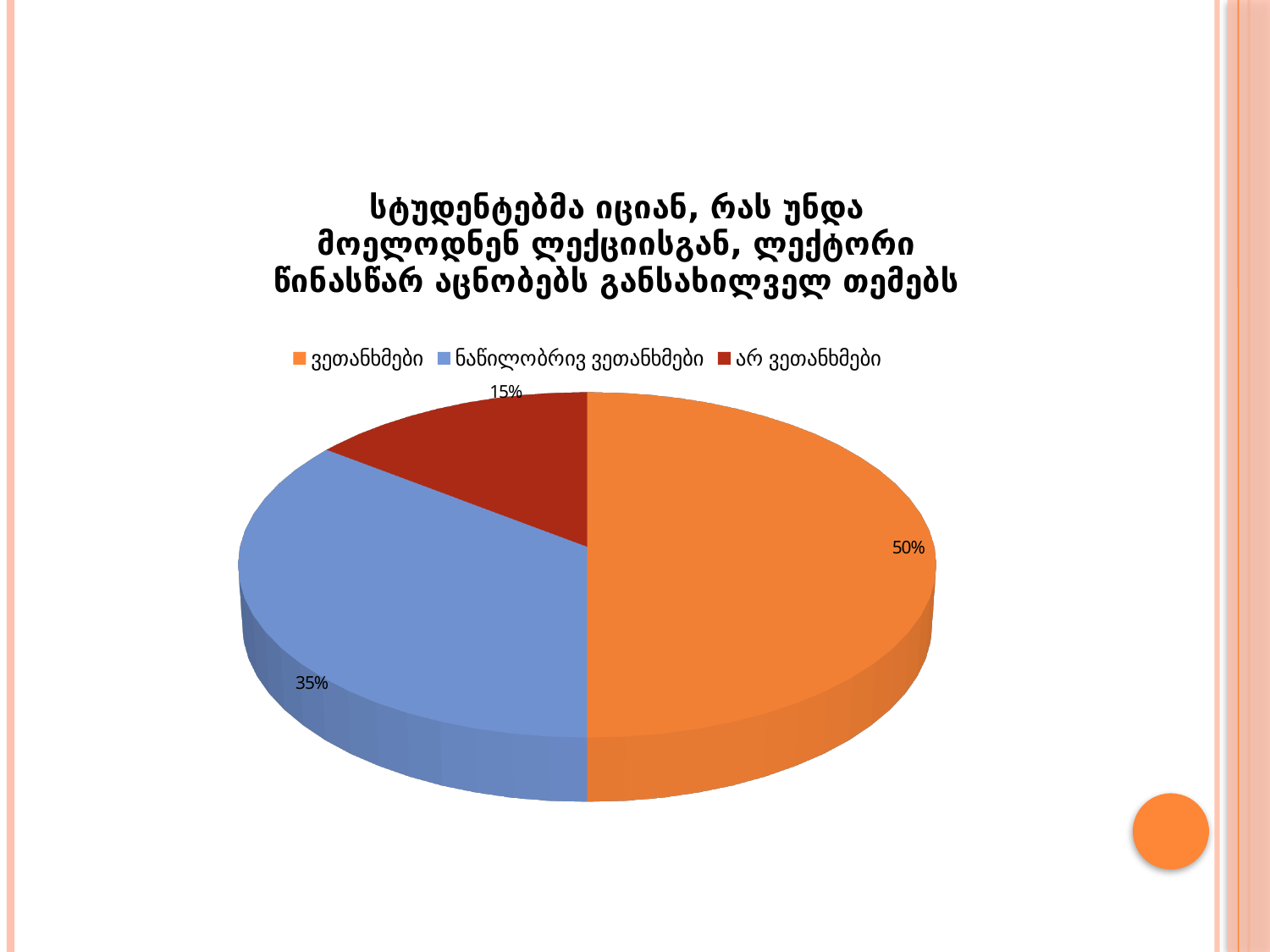
Which is larger, the slice for ნაწილობრივ ვეთანხმები or the slice for არ ვეთანხმები? ნაწილობრივ ვეთანხმები Which category has the largest slice of the pie? ვეთანხმები What share of the pie does არ ვეთანხმები have? 15% Which category has the smallest slice of the pie? არ ვეთანხმები What kind of chart is shown on the slide? pie chart What is the difference in percentage points between ნაწილობრივ ვეთანხმები and არ ვეთანხმები? 20% What share of the pie does ნაწილობრივ ვეთანხმები have? 35% How many slices does the pie chart have? 3 What is the difference in percentage points between ვეთანხმები and ნაწილობრივ ვეთანხმები? 15% How many entries does the legend list? 3 What share of the pie does ვეთანხმები have? 50% What colour is the slice for არ ვეთანხმები? dark red